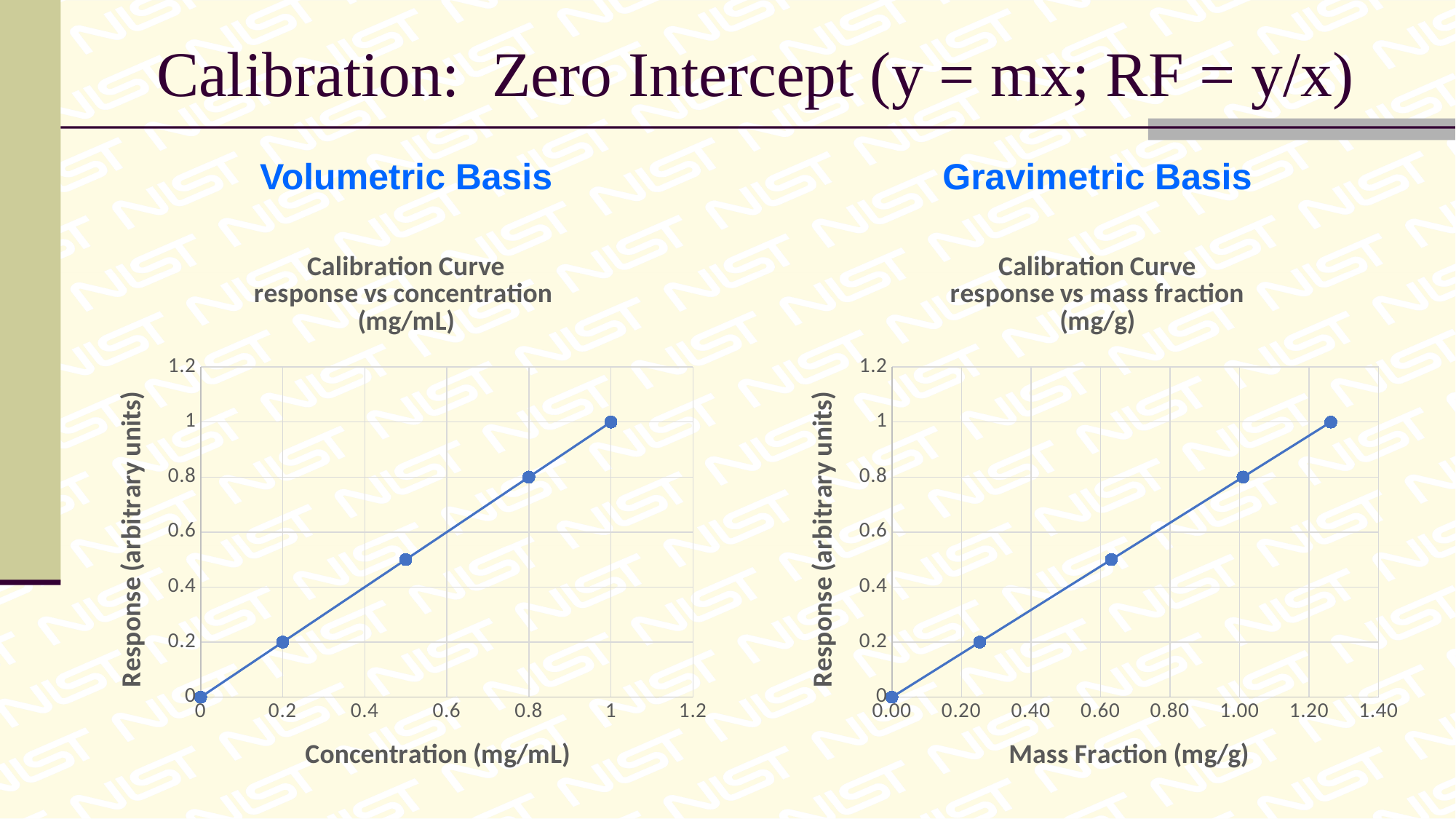
On the right chart (Gravimetric Basis), does the response rise or fall as mass fraction increases? rise What is the y-axis title of the left chart (Volumetric Basis)? Response (arbitrary units) On the right chart (Gravimetric Basis), is the response at the largest mass fraction greater or less than 0.8? greater What is the x-axis title of the right chart (Gravimetric Basis)? Mass Fraction (mg/g) On the right chart (Gravimetric Basis), what is the highest response value plotted? 1 On the left chart (Volumetric Basis), what is the response at a concentration of 1 mg/mL? 1 How many data points are plotted on the right chart (Gravimetric Basis)? 5 What type of chart is the left chart titled 'Calibration Curve response vs concentration (mg/mL)'? line chart On the left chart (Volumetric Basis), what is the highest response value plotted? 1 On the left chart (Volumetric Basis), does the response rise or fall as concentration increases? rise How many data points are plotted on the left chart (Volumetric Basis)? 5 On the left chart (Volumetric Basis), what is the response at a concentration of 0.2 mg/mL? 0.2